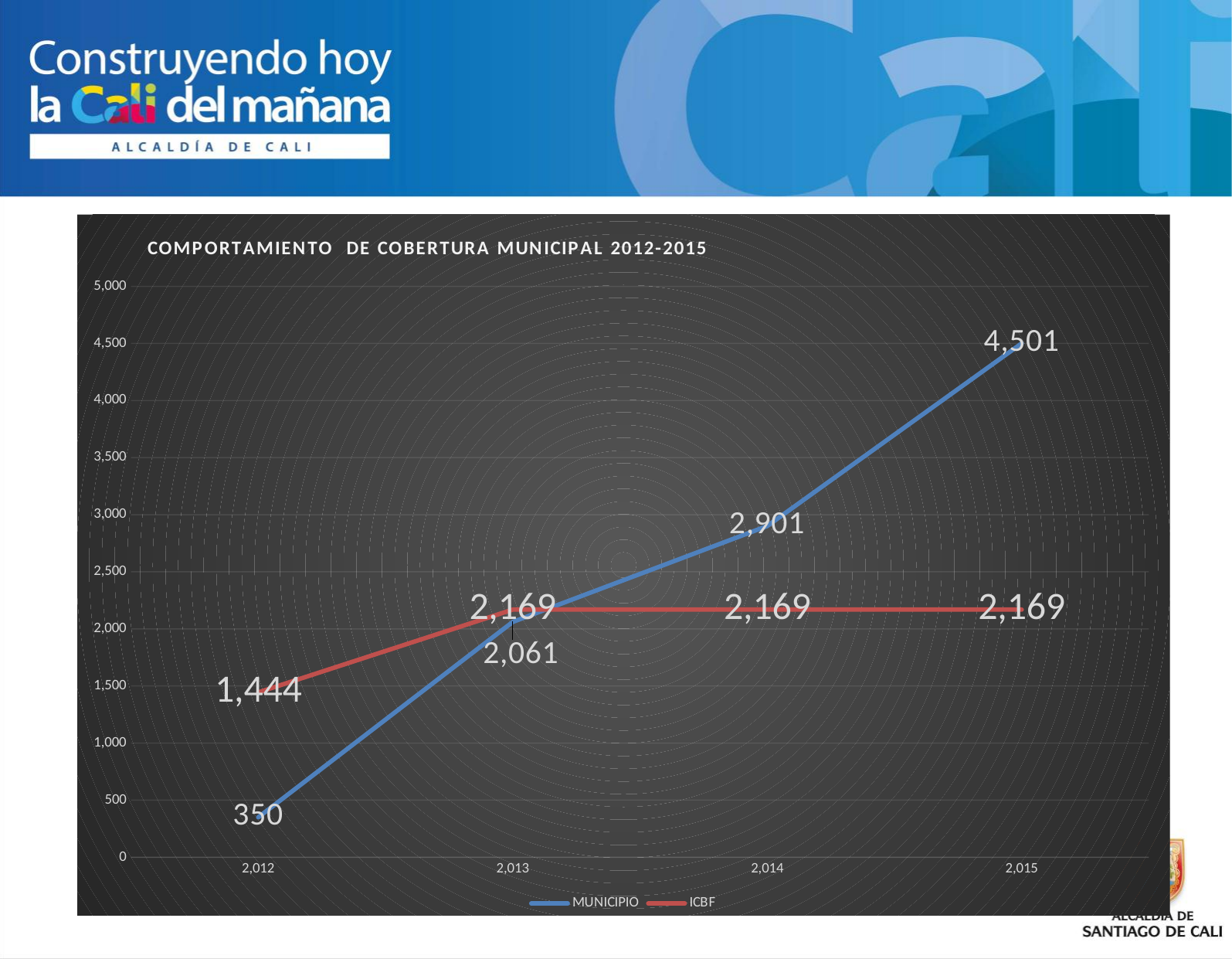
In which year does MUNICIPIO have its lowest value? 2,012 What is the value for ICBF in 2,014? 2,169 What is the value for MUNICIPIO in 2,015? 4,501 How many series does the legend list? 2 What is the value for ICBF in 2,012? 1,444 Which series has the larger value in 2,012, MUNICIPIO or ICBF? ICBF What is the value for MUNICIPIO in 2,012? 350 What type of chart is shown on the slide? Line chart What is the title of the chart? COMPORTAMIENTO DE COBERTURA MUNICIPAL 2012-2015 What is the difference between the MUNICIPIO value in 2,015 and in 2,014? 1,600 In which year does MUNICIPIO reach its highest value? 2,015 Does the MUNICIPIO series rise or fall from 2,012 to 2,015? Rise